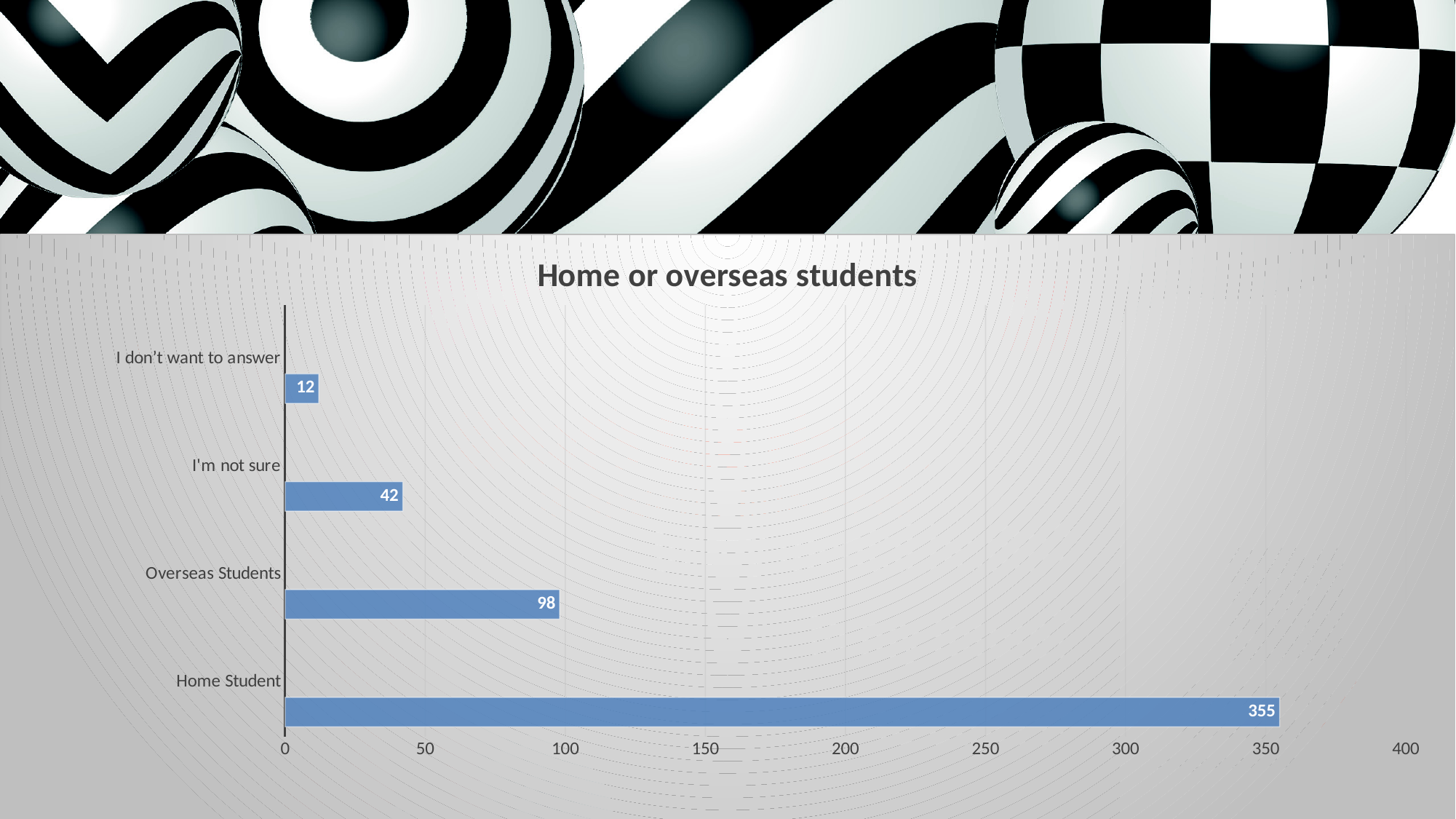
What is the value for Home Student? 355 How many categories are shown in the chart? 4 Which category has the lowest value? I don't want to answer What is the difference between the values for Home Student and Overseas Students? 257 What is the value for I don't want to answer? 12 What is the value for Overseas Students? 98 Which category has the highest value? Home Student What is the value for I'm not sure? 42 What is the difference between the values for Overseas Students and I'm not sure? 56 What type of chart is shown on the slide? Bar chart Is the value for Home Student greater or less than 300? greater Which is larger, the value for I'm not sure or the value for I don't want to answer? I'm not sure